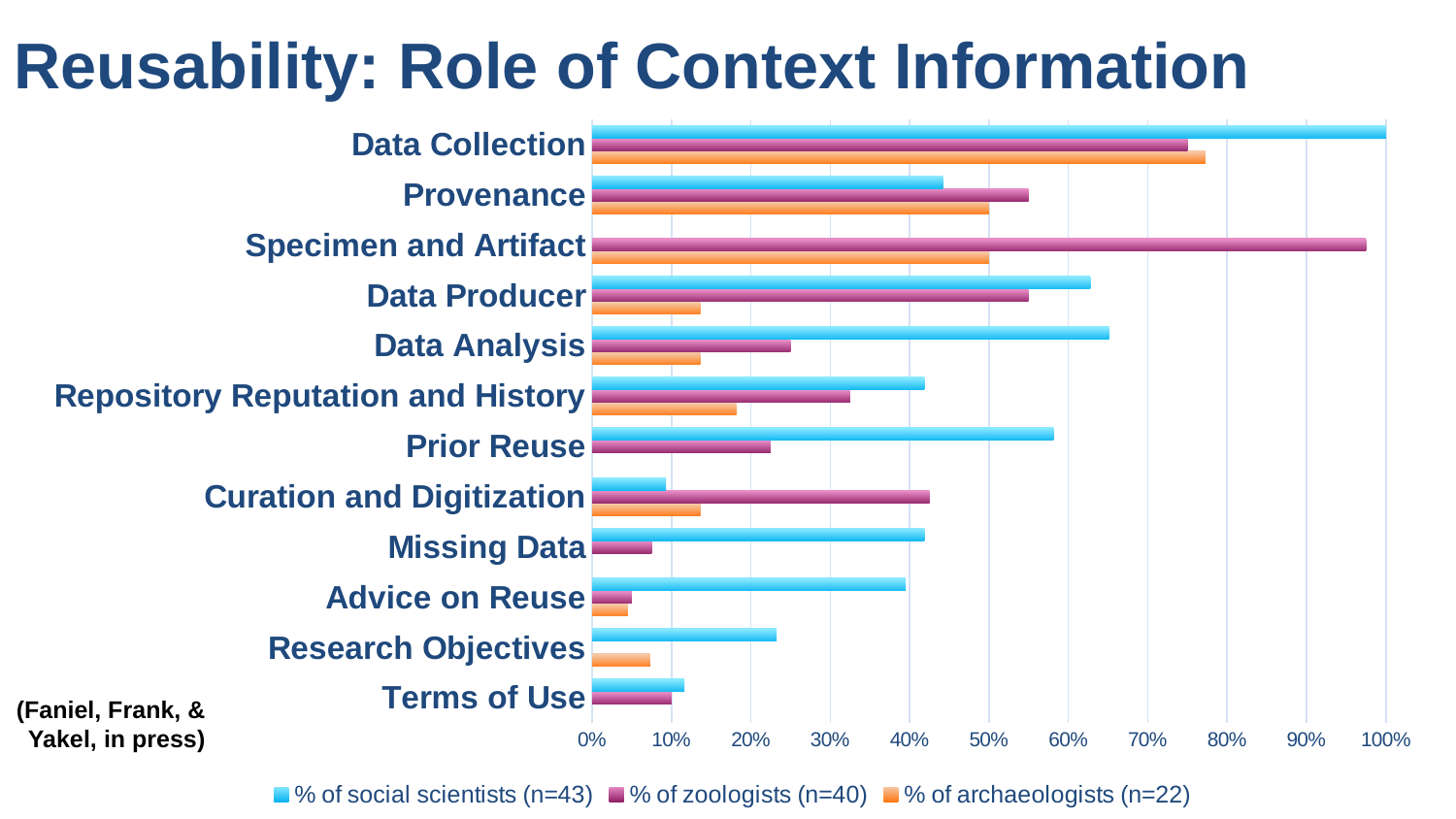
For Data Producer, which is larger: the value for % of social scientists (n=43) or the value for % of archaeologists (n=22)? % of social scientists (n=43) Is the value for Specimen and Artifact for % of zoologists (n=40) greater or less than 90%? greater What is the value for Data Collection for % of social scientists (n=43)? 100% What colour represents % of archaeologists (n=22) in the chart? orange Is the value for Research Objectives for % of archaeologists (n=22) greater or less than 10%? less Which category has the highest value for % of zoologists (n=40)? Specimen and Artifact Which category has the highest value for % of social scientists (n=43)? Data Collection How many context information categories are plotted on the chart? 12 How many series does the legend list? 3 Is the value for Data Analysis for % of social scientists (n=43) greater or less than 60%? greater What type of chart is shown on the slide? bar chart